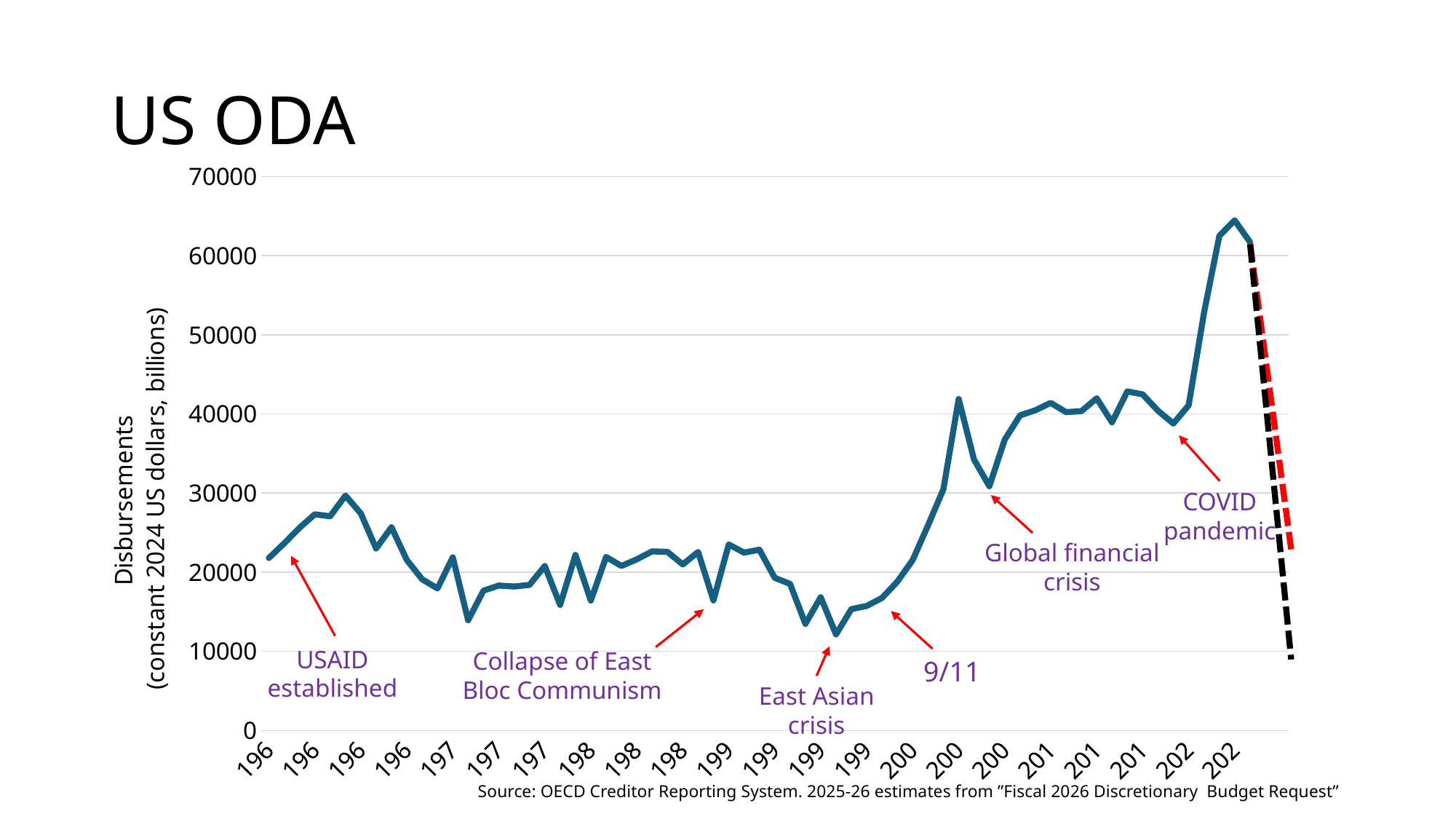
How many annotated events are labelled on the chart? 6 Which annotated event is closest to the lowest point on the line? East Asian crisis Is the value at the low point marked 'East Asian crisis' greater or less than 20000? less Is the value at the peak near the 'COVID pandemic' annotation greater or less than 60000? greater Which annotated event is closest to the highest point on the line? COVID pandemic Is the value at the point marked '9/11' greater or less than 20000? less What is the label on the vertical axis of the chart? Disbursements (constant 2024 US dollars, billions) What is the title of the chart? US ODA What kind of chart is shown on the slide? line chart